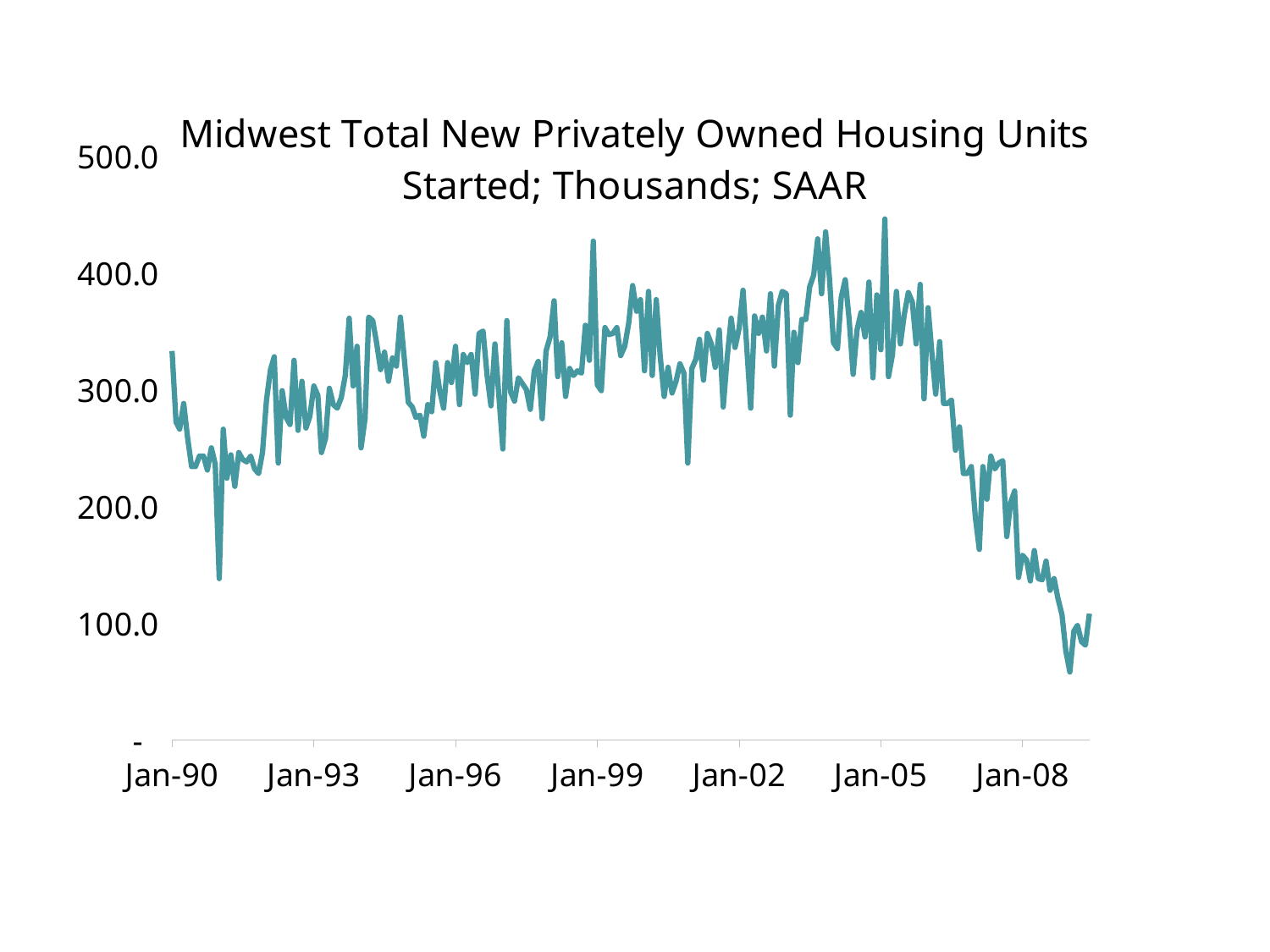
How many series are plotted on the chart? 1 How many year labels are shown on the x axis? 7 Does the series rise or fall between Jan-05 and the end of the chart? fall Around which x-axis label does the series reach its highest value? Jan-05 Is the value at the end of the series higher or lower than the value at Jan-90? lower Is the highest peak of the series, reached shortly after Jan-05, greater or less than 400? greater What is the highest value shown on the y axis? 500.0 What is the title of the chart? Midwest Total New Privately Owned Housing Units Started; Thousands; SAAR Is the value at the end of the series (after Jan-08) greater or less than 200? less Is the value at the start of the series (Jan-90) greater or less than 300? greater What kind of chart is shown on the slide? line chart